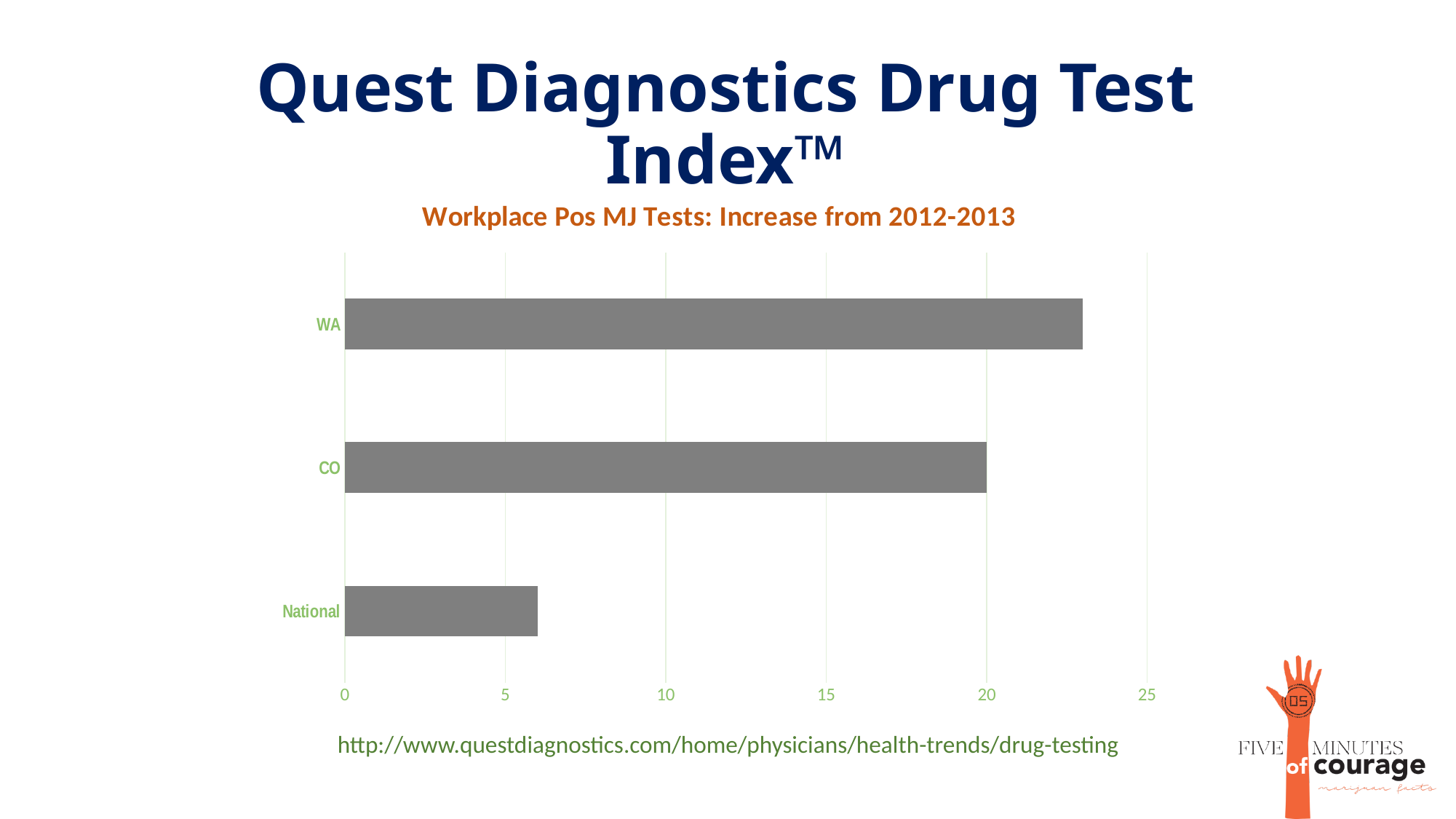
How many categories are plotted in the chart? 3 What is the highest value shown on the chart's horizontal axis? 25 Is the value for WA greater or less than 20? greater What is the value for CO in the chart? 20 Which category has the lowest value in the chart? National Which category has the highest value in the chart? WA What is the title of the chart? Workplace Pos MJ Tests: Increase from 2012-2013 Is the value for WA greater or less than 25? less Is the value for National greater or less than 10? less Which has a larger value, National or CO? CO What kind of chart is shown on the slide? bar chart Which has a larger value, WA or CO? WA